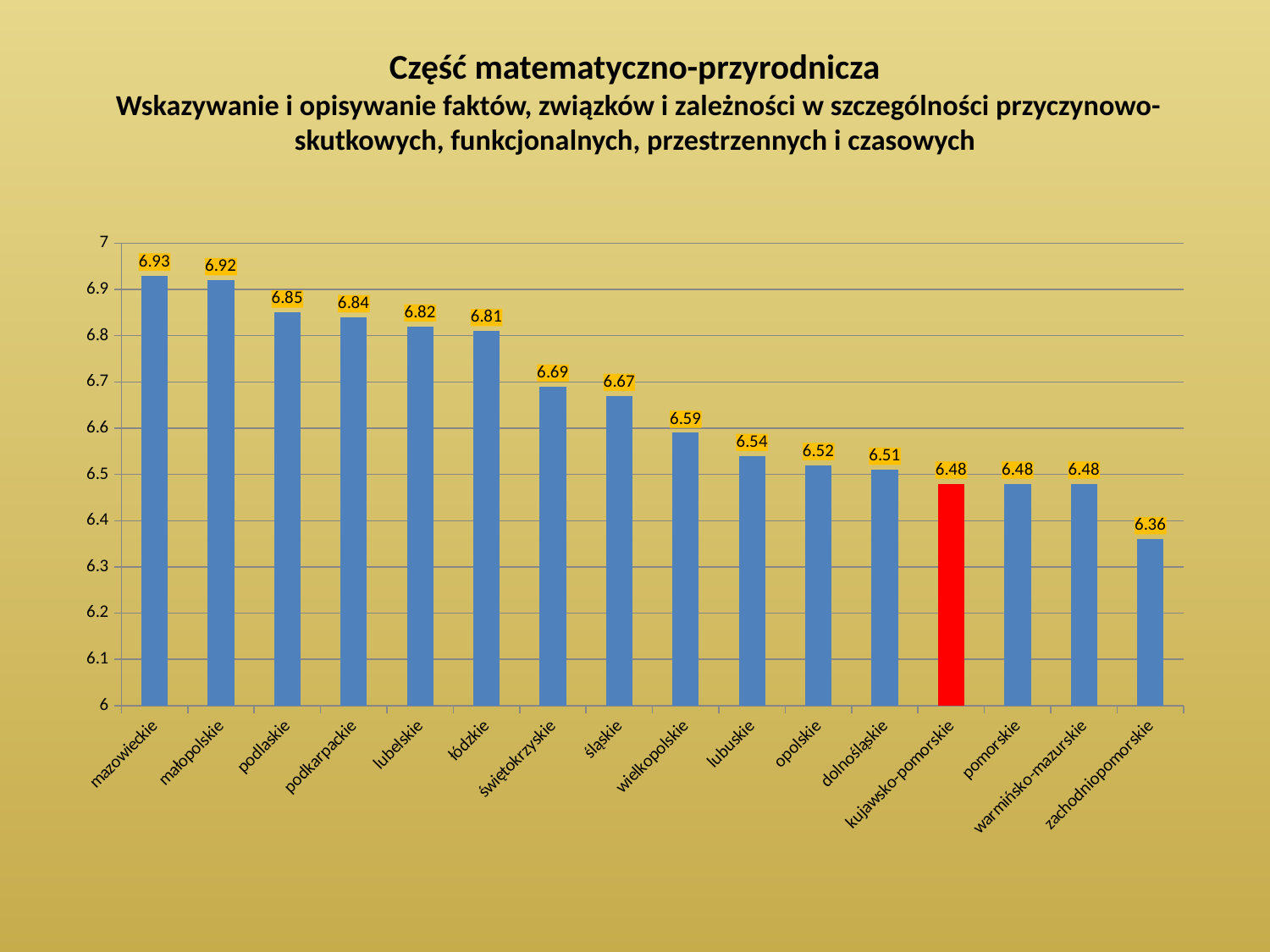
Which voivodeship has the highest value? mazowieckie What kind of chart is shown on the slide? bar chart Which voivodeship has the lowest value? zachodniopomorskie Which is larger, the value for lubelskie or the value for wielkopolskie? lubelskie What is the value for mazowieckie? 6.93 What is the value for kujawsko-pomorskie? 6.48 How many voivodeships are shown on the chart? 16 Do the values rise or fall from left to right along the x axis? fall Which voivodeship's bar is coloured red? kujawsko-pomorskie What is the difference between the values for mazowieckie and zachodniopomorskie? 0.57 What is the value for świętokrzyskie? 6.69 What is the value for zachodniopomorskie? 6.36